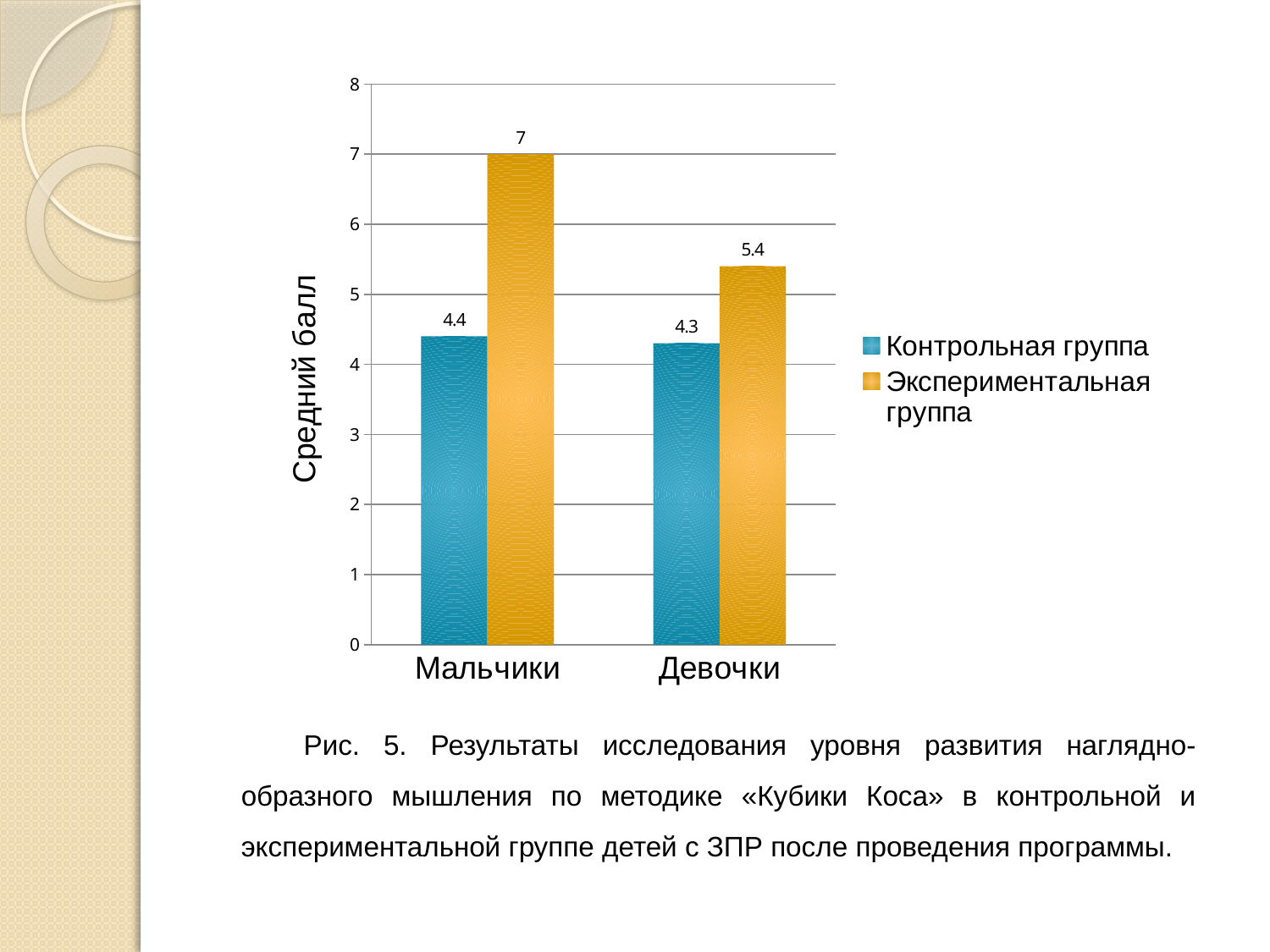
What kind of chart is shown on the slide? bar chart How many series does the legend list? 2 What is the difference between the Экспериментальная группа and Контрольная группа values for Мальчики? 2.6 What is the value for Экспериментальная группа for Мальчики? 7 Is the value for Экспериментальная группа for Мальчики greater or less than 6? greater What is the value for Контрольная группа for Мальчики? 4.4 What is the difference between the Экспериментальная группа and Контрольная группа values for Девочки? 1.1 Which is larger for Девочки: Контрольная группа or Экспериментальная группа? Экспериментальная группа How many categories are shown on the x axis? 2 What is the value for Контрольная группа for Девочки? 4.3 Which category has the highest value for Экспериментальная группа? Мальчики What is the value for Экспериментальная группа for Девочки? 5.4